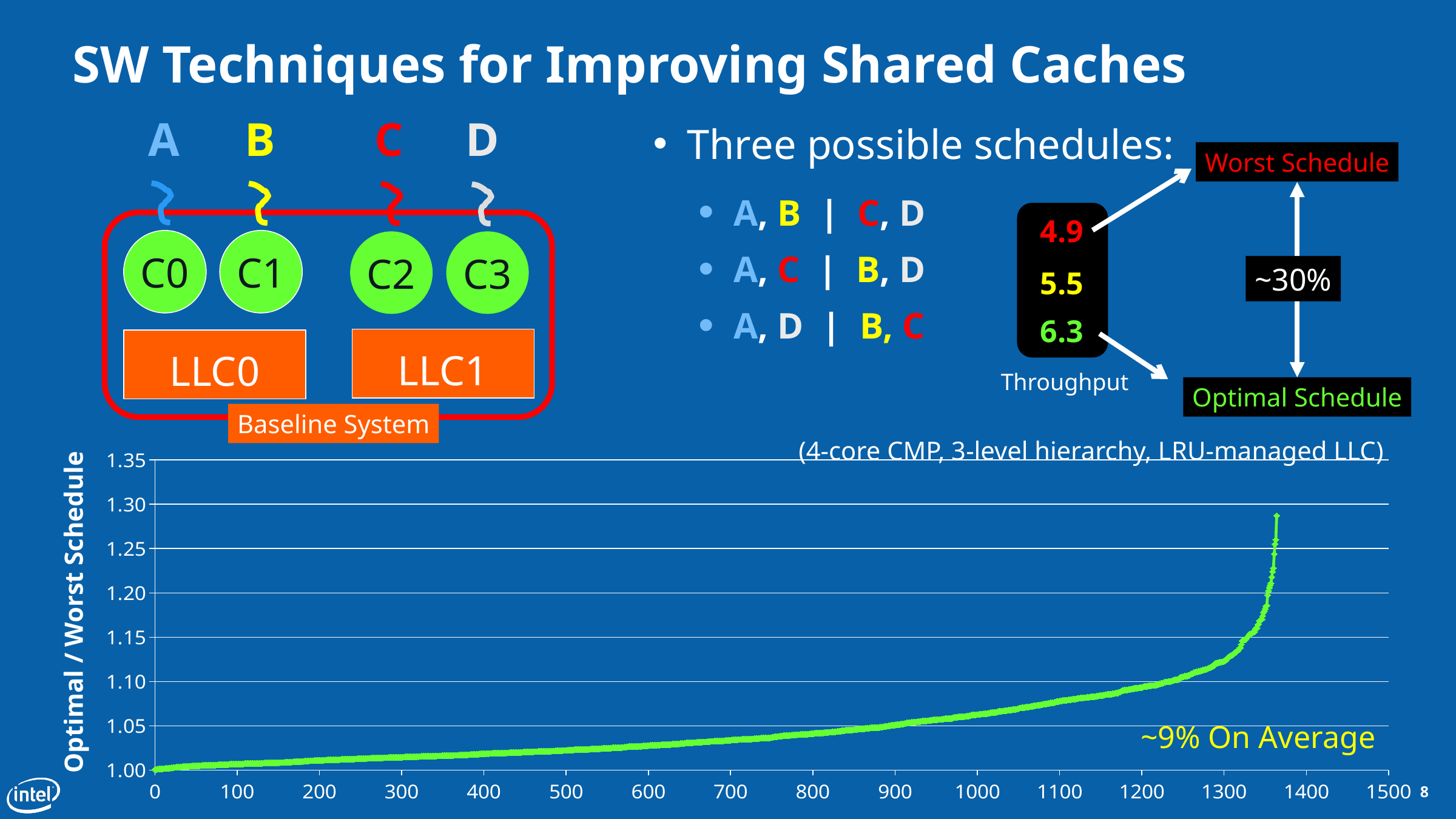
Is the value of the line at x = 1000 greater or less than 1.10? less Is the value of the line at x = 500 greater or less than 1.05? less What average improvement does the annotation on the chart state? ~9% On Average Is the maximum value reached by the line greater or less than 1.25? greater What is the label on the y-axis of the chart? Optimal / Worst Schedule What kind of chart is shown at the bottom of the slide? line chart Do the plotted values rise or fall as the x-axis value increases? rise What is the highest tick value shown on the y-axis? 1.35 How many data series are plotted on the chart? 1